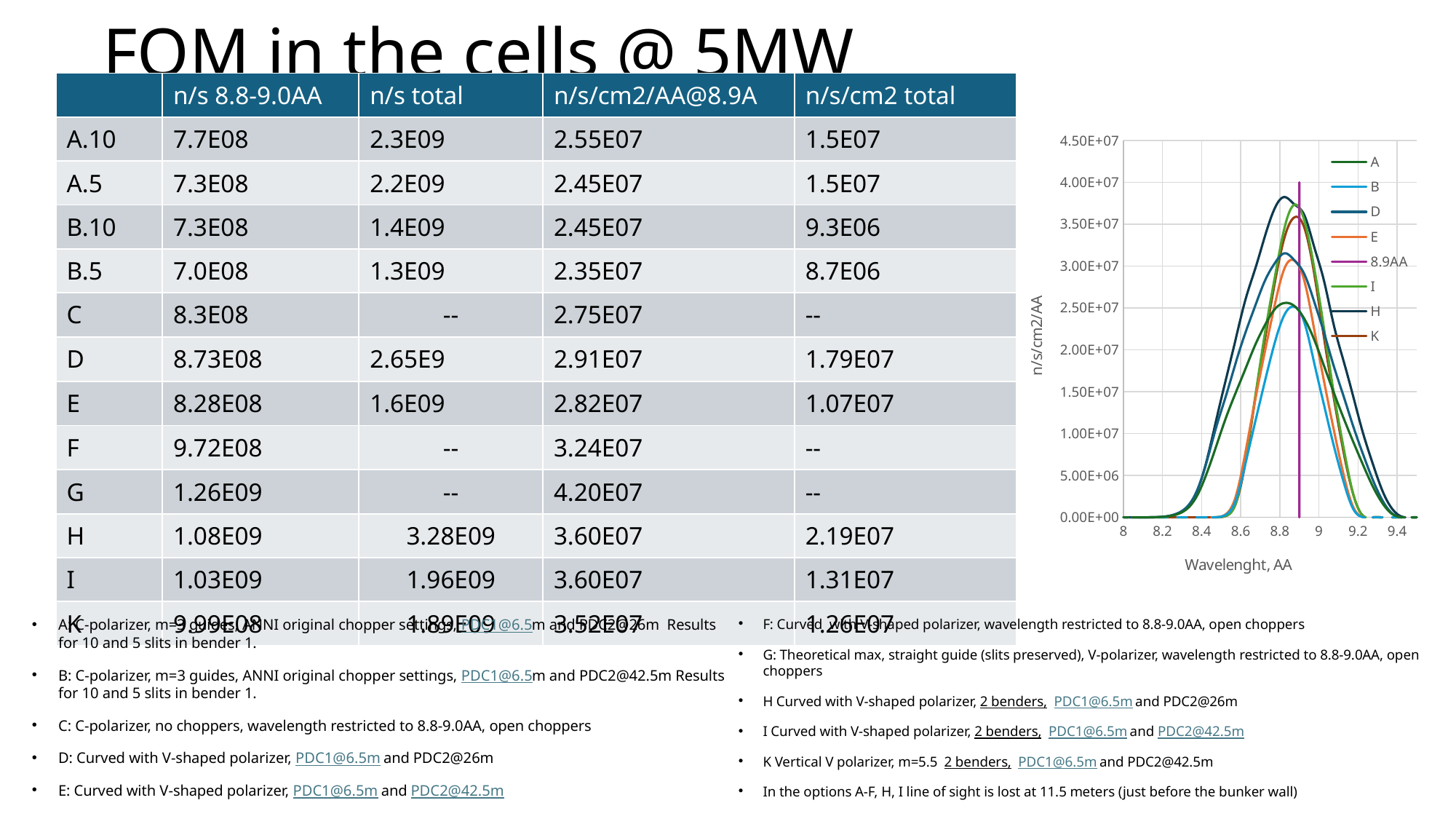
Which series reaches a higher peak, D or A? D Is the peak value of series H greater or less than 3.50E+07? greater Is the peak value of series B greater or less than 3.00E+07? less Is the peak value of series A greater or less than 3.00E+07? less Do the curves rise or fall along the x axis between 8.4 and 8.8? rise Do the curves rise or fall along the x axis between 9.0 and 9.4? fall What is the label of the y axis of the chart? n/s/cm2/AA How many series does the legend of the chart list? 8 What is the label of the x axis of the chart? Wavelenght, AA What kind of chart is shown on the right of the slide? line chart Which series reaches a higher peak, H or B? H